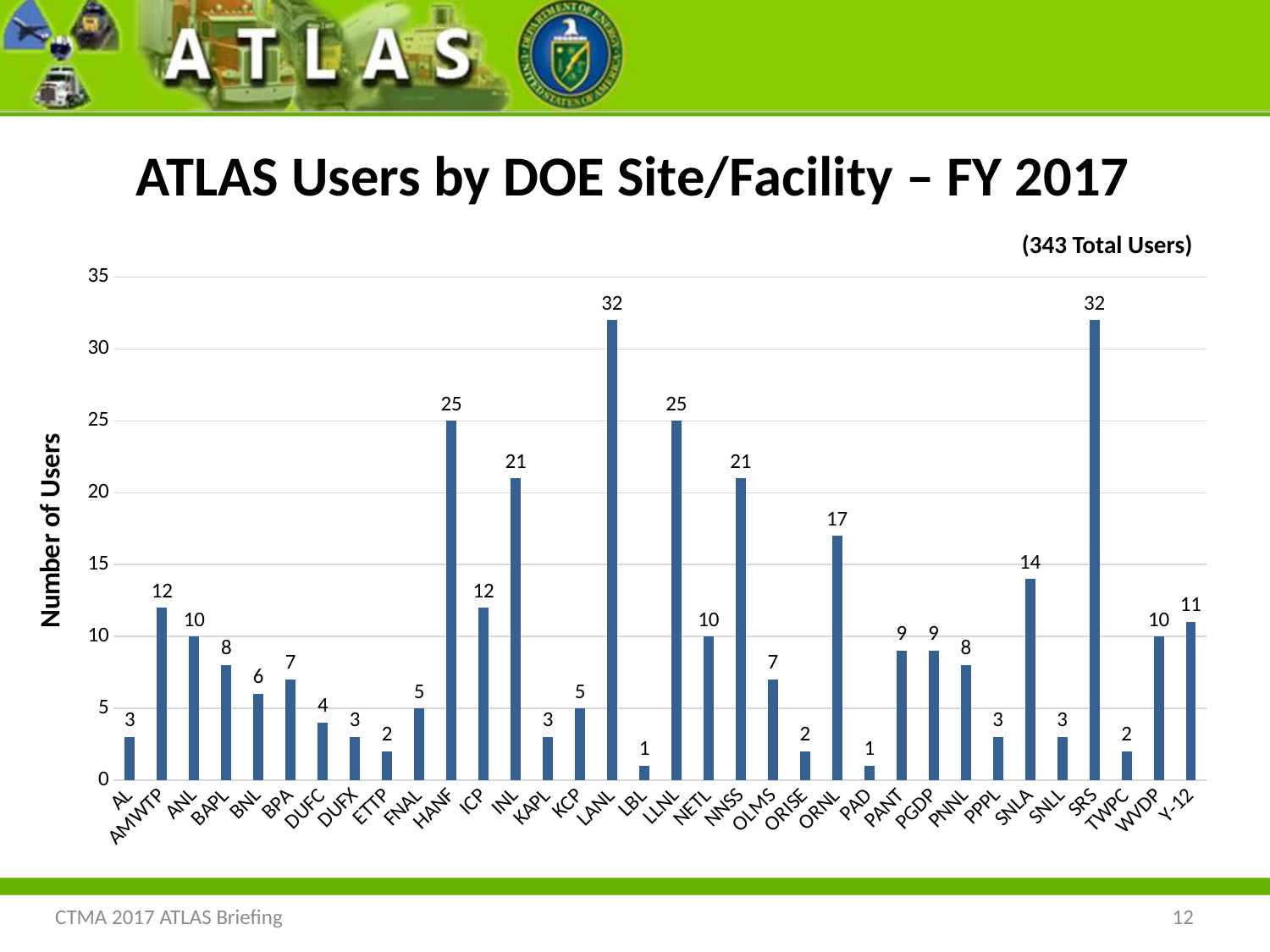
Which has fewer users, BNL or BPA? BNL How many ATLAS users does HANF have? 25 What is the value for Y-12? 11 Is the value for SRS greater or less than 30? greater What is the value shown for ORNL? 17 What kind of chart is shown on the slide? bar chart What is the difference between the values for INL and ICP? 9 Which has more users, NNSS or NETL? NNSS What is the difference between the values for LANL and LLNL? 7 What is the title of the chart? ATLAS Users by DOE Site/Facility – FY 2017 How many users are shown for SNLA? 14 How many DOE sites/facilities are shown on the x axis? 34